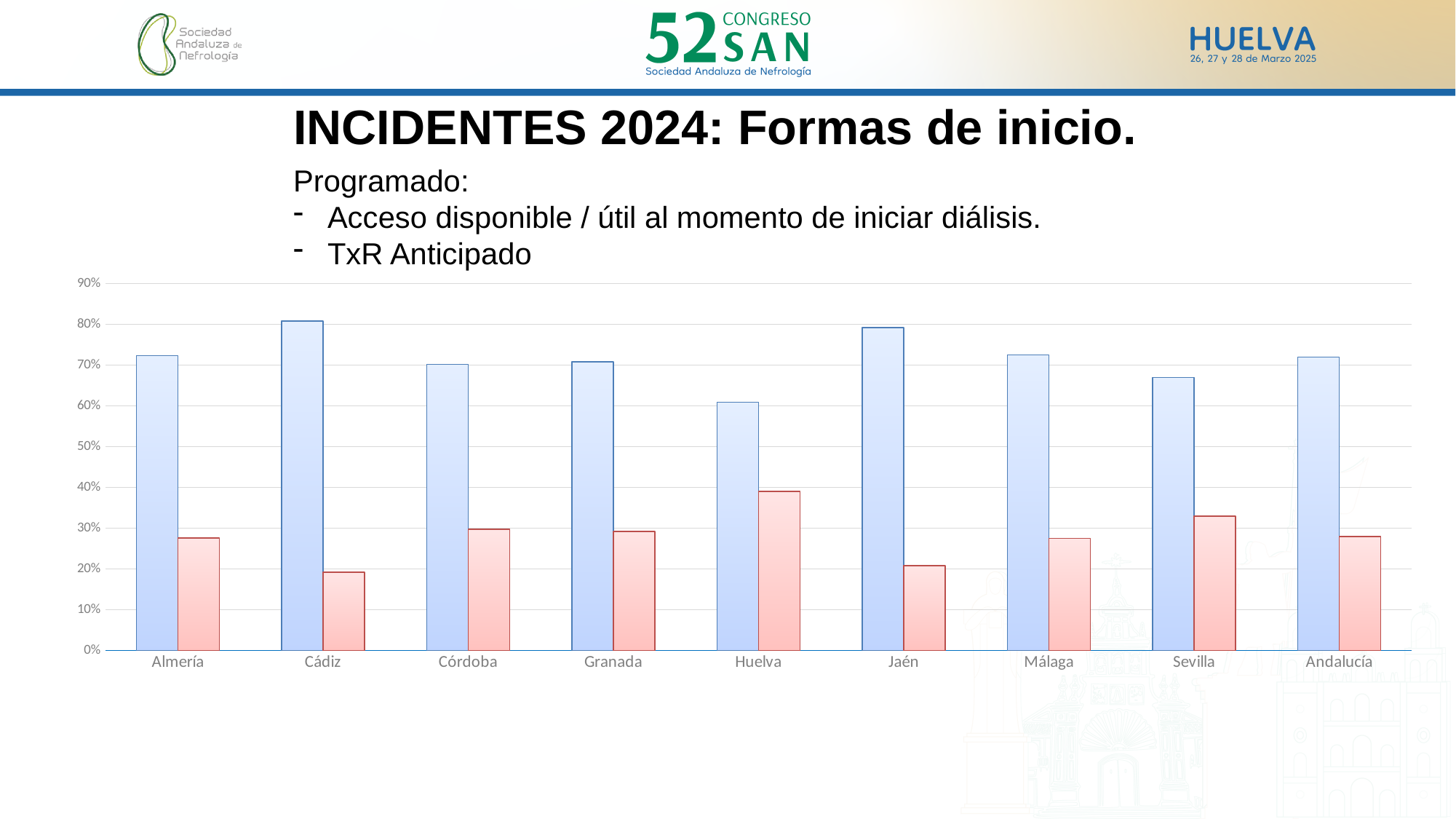
Is the red bar for Cádiz greater or less than 30%? less Which category has the tallest red bar? Huelva Is the blue bar for Cádiz greater or less than 70%? greater Which has the larger red bar, Huelva or Jaén? Huelva How many bars are plotted for each category in the chart? 2 Which has the larger blue bar, Huelva or Sevilla? Sevilla Which category has the shortest blue bar? Huelva What kind of chart is shown on the slide? bar chart Which category has the tallest blue bar? Cádiz Is the red bar for Huelva greater or less than 30%? greater How many categories are shown on the x axis of the chart? 9